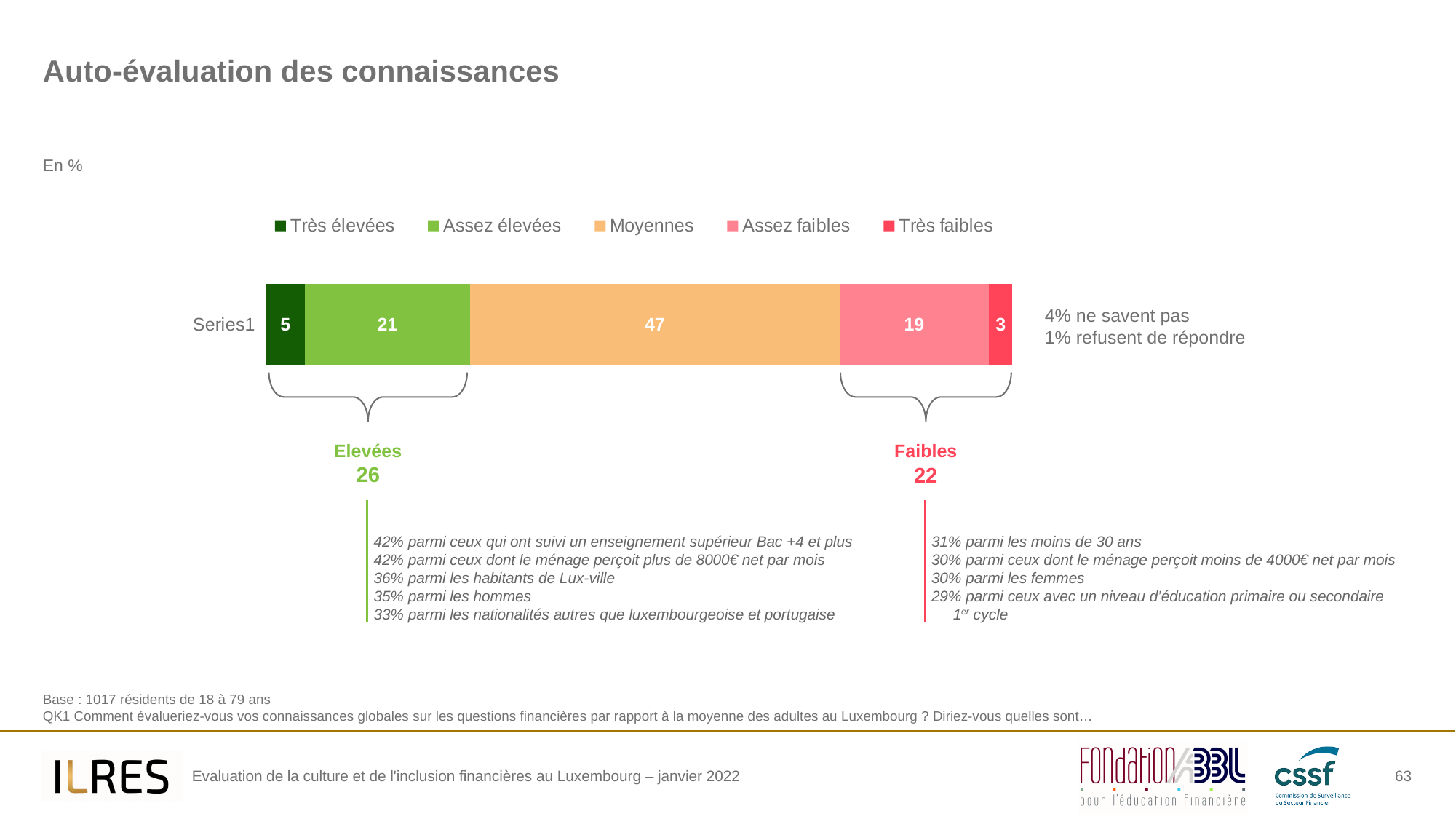
Which legend category has the lowest value in the bar? Très faibles What is the value for "Moyennes" in the stacked bar? 47 What combined value is shown under the "Faibles" bracket? 22 What is the total of the five segments in the stacked bar? 95 Which is larger, the value for "Très élevées" or the value for "Très faibles"? Très élevées What is the difference between the values for "Assez élevées" and "Assez faibles"? 2 How many series does the legend list? 5 Which legend category has the highest value in the bar? Moyennes What kind of chart is shown on the slide? Stacked bar chart What is the value for "Assez élevées" in the stacked bar? 21 What is the value for "Très faibles" in the stacked bar? 3 What combined value is shown under the "Elevées" bracket? 26